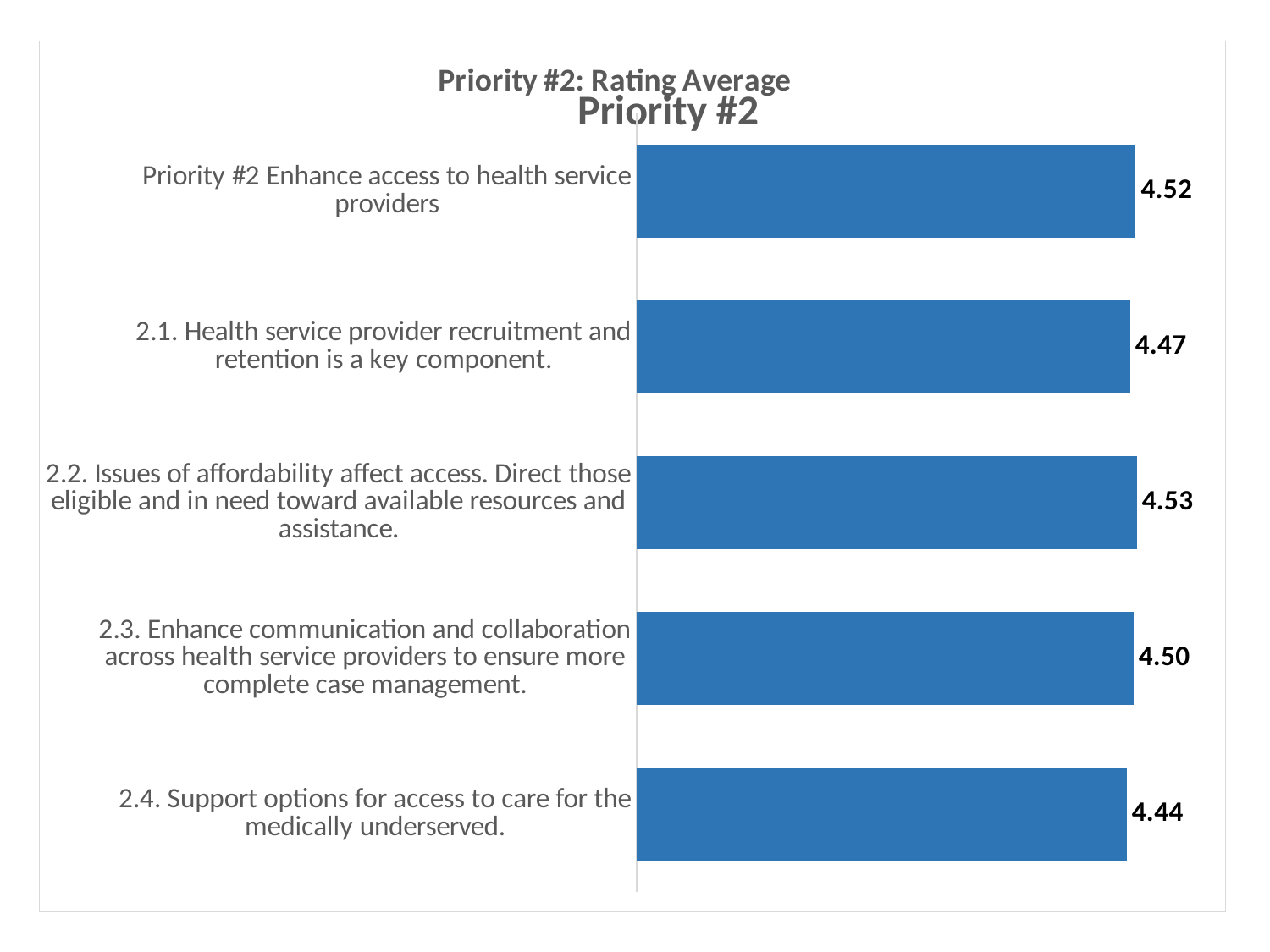
How many categories are shown in the chart? 5 What is the difference between the rating average for "Priority #2 Enhance access to health service providers" and for 2.1? 0.05 Which category has the lowest rating average? 2.4. Support options for access to care for the medically underserved. What kind of chart is shown on the slide? Bar chart What is the difference between the rating average for 2.2 and the rating average for 2.4? 0.09 Which has a higher rating average, 2.1 or 2.3? 2.3. Enhance communication and collaboration across health service providers to ensure more complete case management. What is the rating average for "Priority #2 Enhance access to health service providers"? 4.52 What is the rating average for "2.3. Enhance communication and collaboration across health service providers to ensure more complete case management."? 4.50 What is the rating average for "2.1. Health service provider recruitment and retention is a key component."? 4.47 What is the rating average for "2.4. Support options for access to care for the medically underserved."? 4.44 What is the rating average for "2.2. Issues of affordability affect access. Direct those eligible and in need toward available resources and assistance."? 4.53 Which category has the highest rating average? 2.2. Issues of affordability affect access. Direct those eligible and in need toward available resources and assistance.